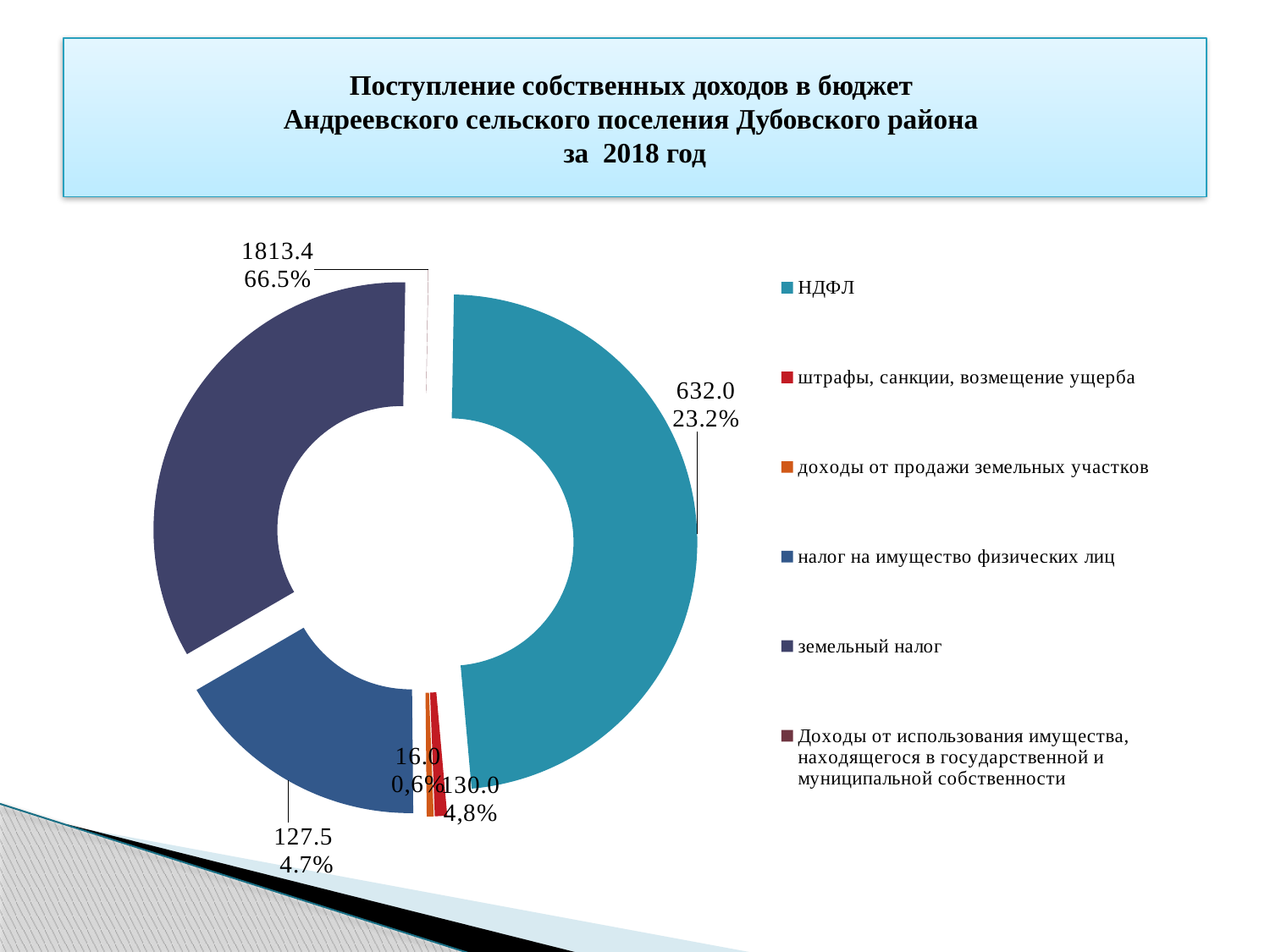
What percentage share is shown for НДФЛ? 23.2% For which year does the chart title say the revenue data is shown? 2018 What is the value shown for налог на имущество физических лиц? 127.5 Which is larger, the value for НДФЛ or the value for налог на имущество физических лиц? НДФЛ What share of the total does земельный налог represent? 66.5% What type of chart is shown on the slide? doughnut (pie) chart What is the difference between the values for земельный налог and НДФЛ? 1181.4 What percentage share is shown for налог на имущество физических лиц? 4.7% What is the value shown for земельный налог? 1813.4 Which category has the largest slice in the chart? НДФЛ How many entries does the legend list? 6 What is the value shown for НДФЛ? 632.0